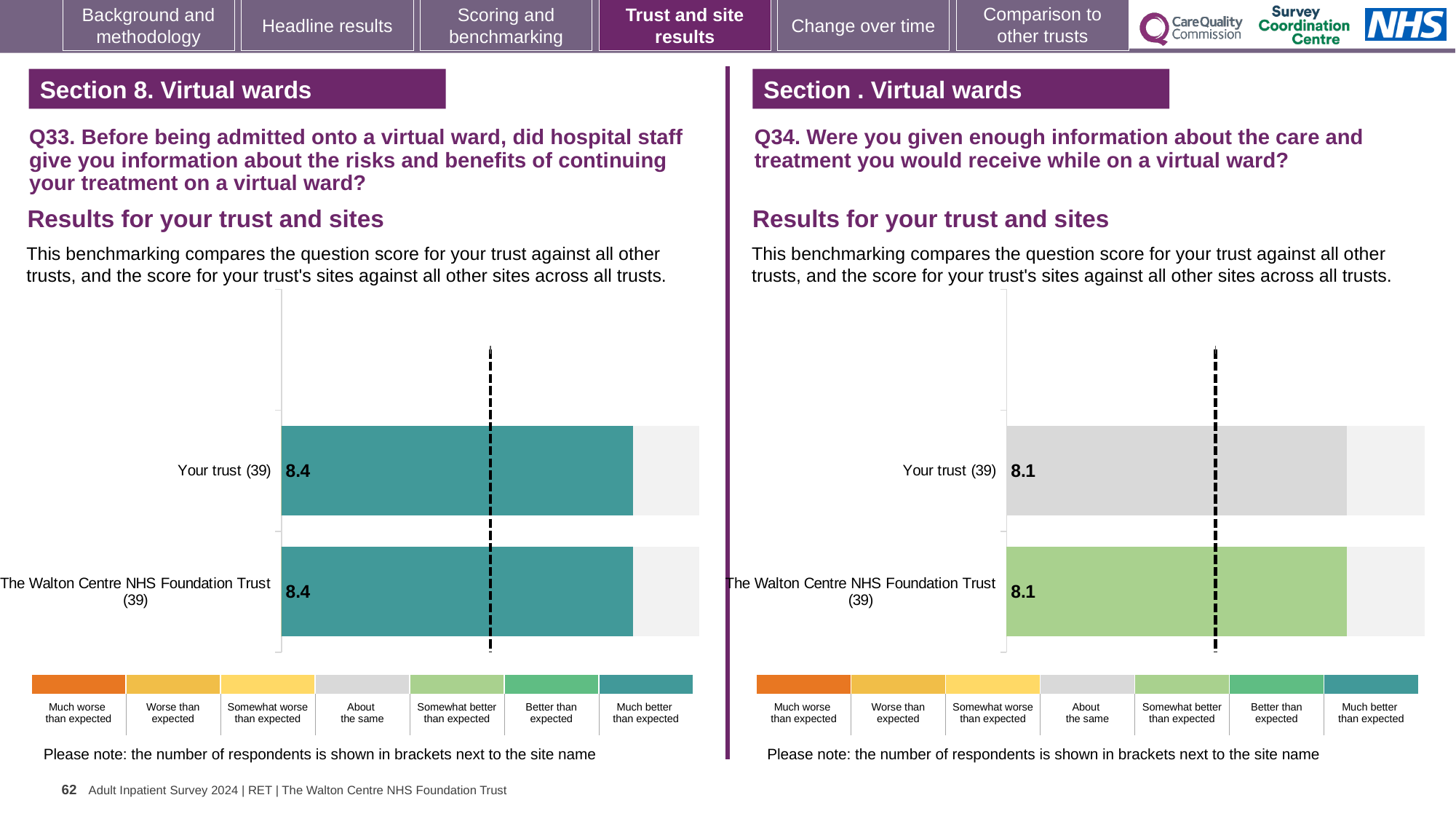
How many bars are plotted in the Q34 chart on the right? 2 How many respondents are shown in brackets next to Your trust in the Q34 chart on the right? 39 In the Q34 chart on the right, what is the score for The Walton Centre NHS Foundation Trust? 8.1 In the Q33 chart on the left, what is the difference between the score for Your trust and the score for The Walton Centre NHS Foundation Trust? 0 In the Q34 chart on the right, what is the score for Your trust? 8.1 In the Q33 chart on the left, which benchmark category does the colour of the bars correspond to in the legend? Much better than expected In the Q34 chart on the right, what is the difference between the score for Your trust and the score for The Walton Centre NHS Foundation Trust? 0 What kind of chart is used for the Q33 results on the left? Bar chart In the Q34 chart on the right, which benchmark category does the colour of the Your trust bar correspond to in the legend? About the same In the Q33 chart on the left, what is the score for The Walton Centre NHS Foundation Trust? 8.4 How many bars are plotted in the Q33 chart on the left? 2 In the Q33 chart on the left, what is the score for Your trust? 8.4